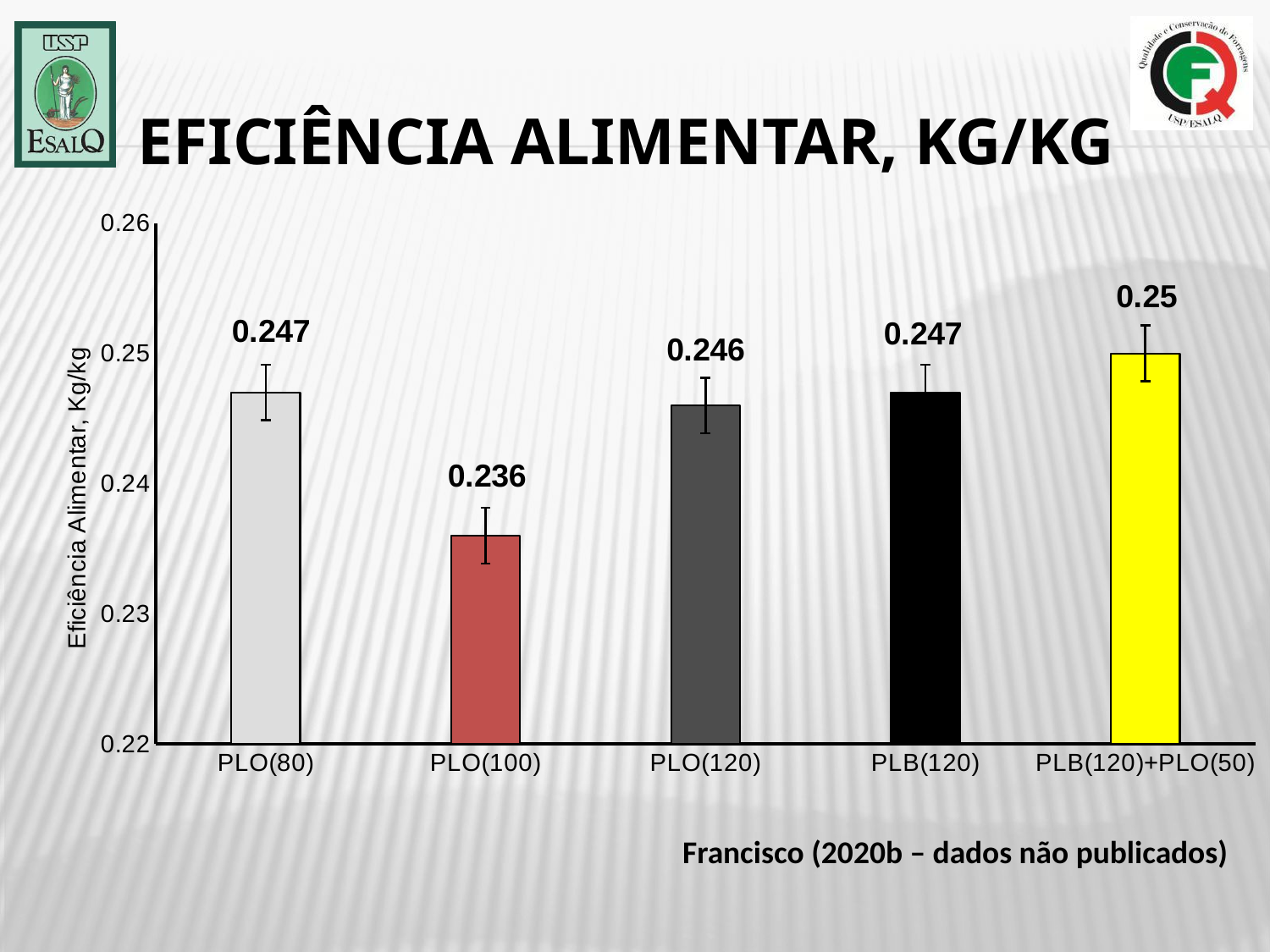
What is the value for PLO(120)? 0.246 What is the value for PLO(100)? 0.236 Which category has the highest value? PLB(120)+PLO(50) Is the value for PLO(100) greater or less than 0.24? less How many categories are shown on the x axis? 5 Which category has the lowest value? PLO(100) Which is larger, the value for PLO(100) or the value for PLO(120)? PLO(120) What is the difference between the values for PLO(80) and PLO(100)? 0.011 What is the difference between the values for PLB(120)+PLO(50) and PLO(100)? 0.014 What colour is the bar for PLB(120)+PLO(50)? yellow What kind of chart is shown on the slide? bar chart What is the value for PLB(120)+PLO(50)? 0.25